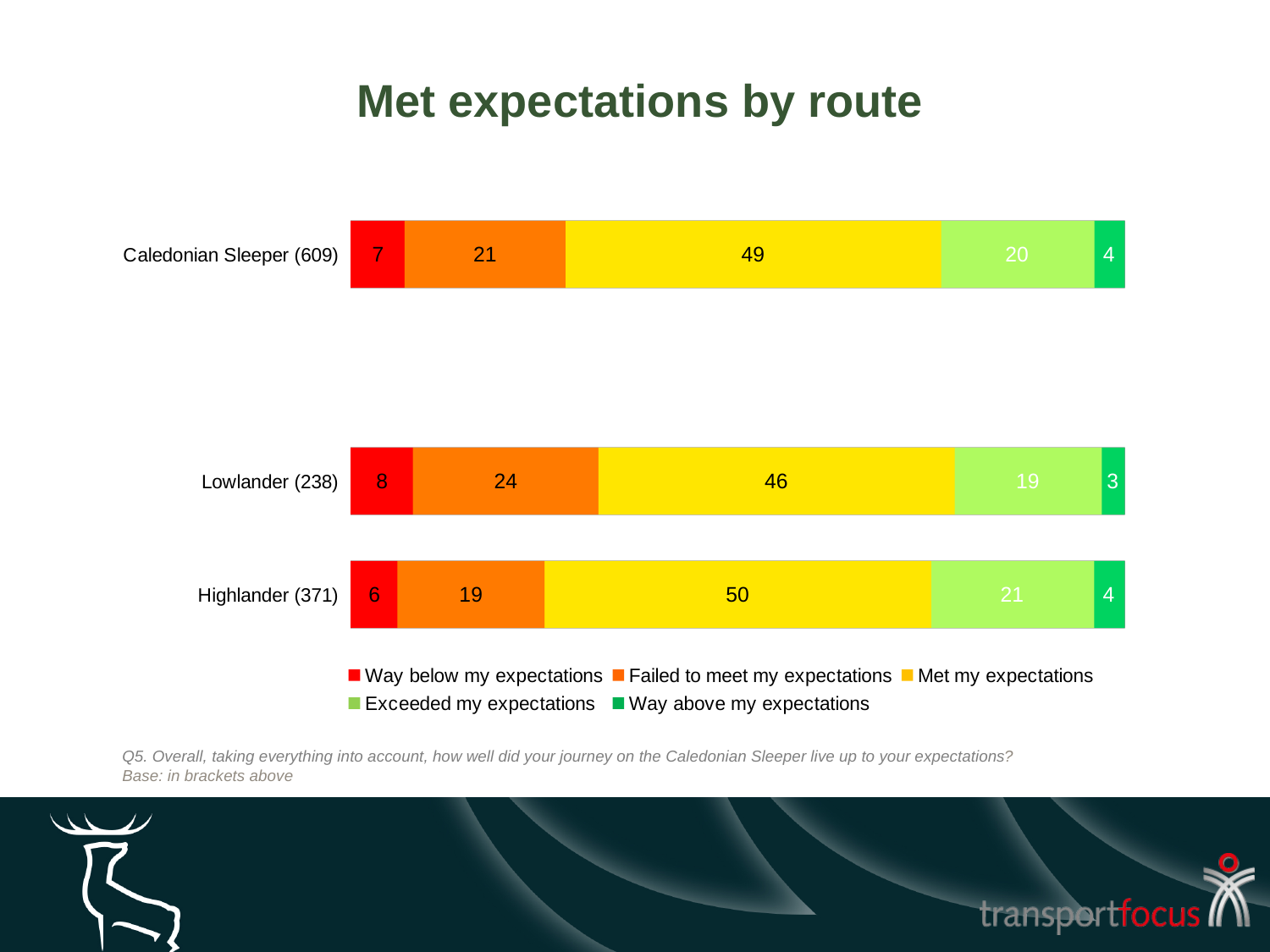
What is the value for 'Met my expectations' for Highlander (371)? 50 Which is larger: 'Exceeded my expectations' for Caledonian Sleeper (609) or for Highlander (371)? Highlander (371) What is the title of the chart? Met expectations by route What is the value for 'Exceeded my expectations' for Lowlander (238)? 19 How many routes (bars) are shown in the chart? 3 What is the value for 'Failed to meet my expectations' for Lowlander (238)? 24 What kind of chart is shown on the slide? Stacked bar chart How many series does the legend list? 5 What is the difference between the 'Failed to meet my expectations' values for Lowlander (238) and Highlander (371)? 5 Which route has the lowest value for 'Way below my expectations'? Highlander (371) What is the value for 'Way above my expectations' for Caledonian Sleeper (609)? 4 Which route has the highest value for 'Met my expectations'? Highlander (371)